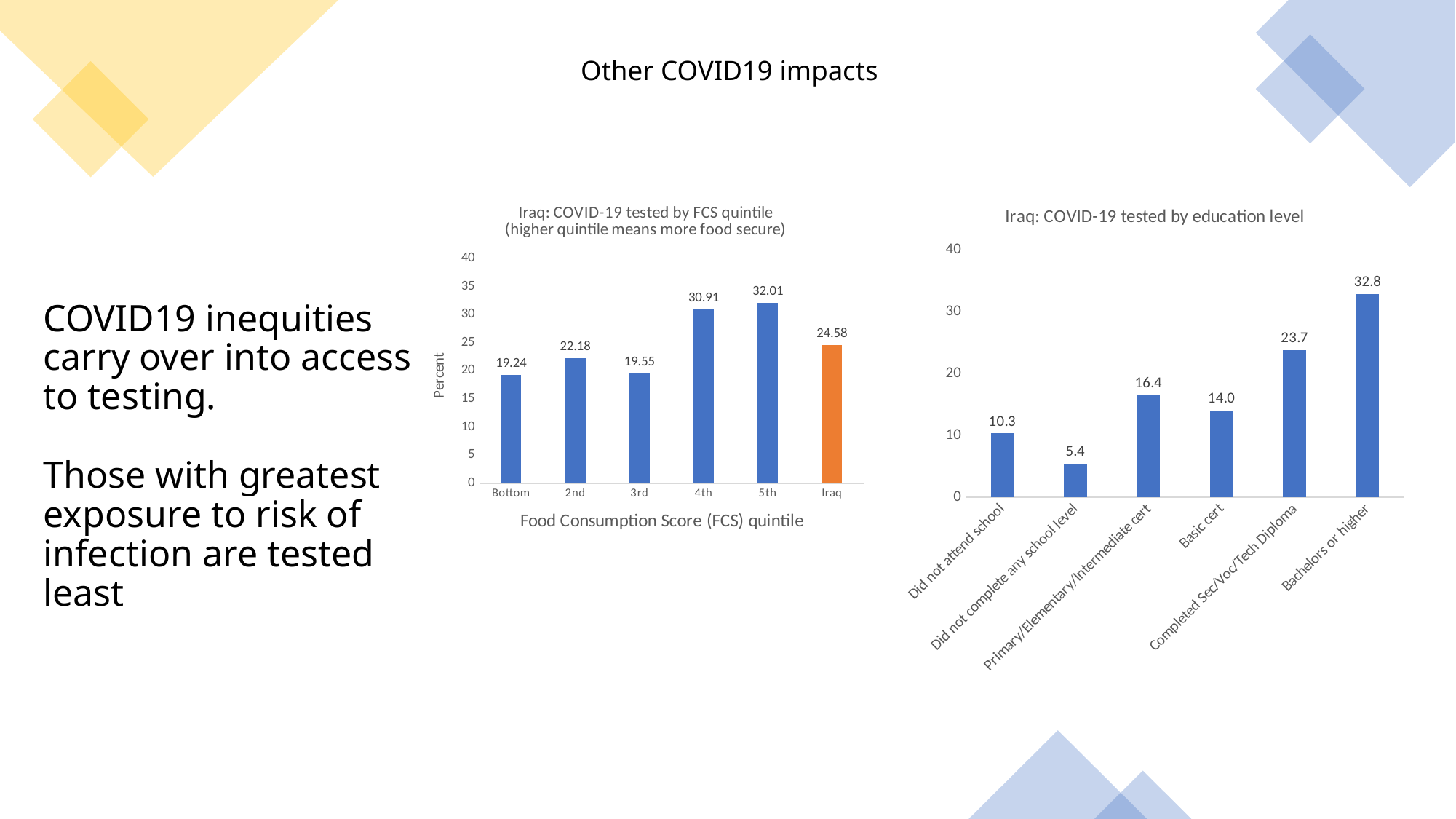
In the chart 'Iraq: COVID-19 tested by FCS quintile', how many bars are plotted? 6 What type of chart is 'Iraq: COVID-19 tested by education level'? Bar chart In the chart 'Iraq: COVID-19 tested by education level', what is the value for Basic cert? 14.0 In the chart 'Iraq: COVID-19 tested by FCS quintile', what is the value for the 4th quintile? 30.91 In the chart 'Iraq: COVID-19 tested by FCS quintile', which category has the lowest value? Bottom In the chart 'Iraq: COVID-19 tested by education level', which category has the lowest value? Did not complete any school level In the chart 'Iraq: COVID-19 tested by education level', what is the difference between Bachelors or higher and Did not attend school? 22.5 In the chart 'Iraq: COVID-19 tested by FCS quintile', what is the difference between the 5th quintile and the Bottom quintile? 12.77 In the chart 'Iraq: COVID-19 tested by FCS quintile', what is the value for Iraq overall? 24.58 In the chart 'Iraq: COVID-19 tested by education level', which category has the highest value? Bachelors or higher In the chart 'Iraq: COVID-19 tested by FCS quintile', which quintile has the highest value? 5th In the chart 'Iraq: COVID-19 tested by FCS quintile', what is the y-axis label? Percent